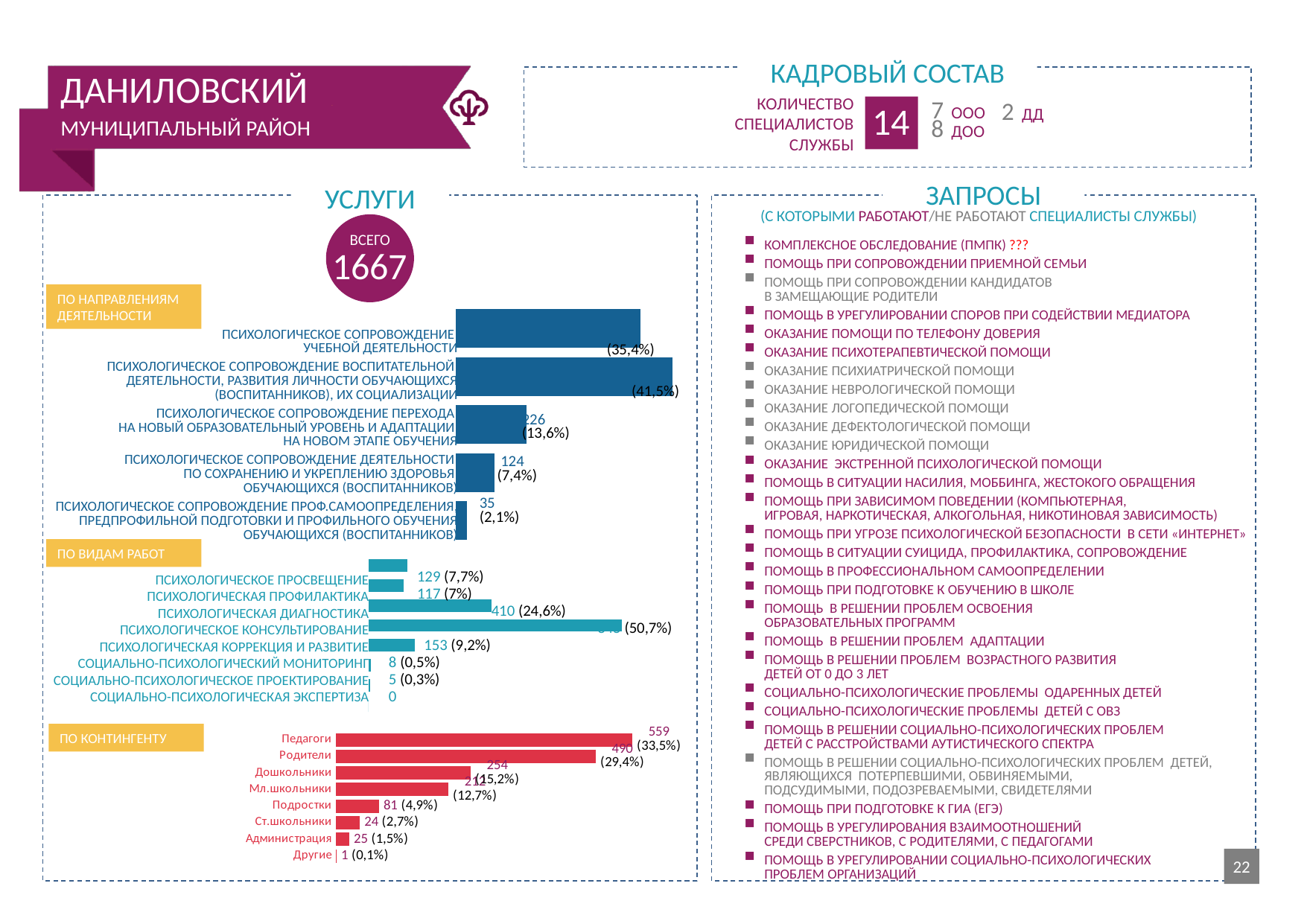
In the 'По видам работ' chart, which category has the highest value? Психологическое консультирование In the 'По контингенту' chart, which category has the highest value? Педагоги In the 'По видам работ' chart, what value is shown for Психологическая диагностика? 410 (24,6%) In the 'По видам работ' chart, what value is shown for Психологическое просвещение? 129 (7,7%) What type of chart is used in the 'По направлениям деятельности' section? Bar chart In the 'По видам работ' chart, what is the difference between Психологическая диагностика and Психологическая коррекция и развитие? 257 In the 'По контингенту' chart, which is larger: Родители or Дошкольники? Родители In the 'По видам работ' chart, which category has the lowest value? Социально-психологическая экспертиза In the 'По направлениям деятельности' chart, what value is shown for Психологическое сопровождение деятельности по сохранению и укреплению здоровья обучающихся? 124 (7,4%) In the 'По контингенту' chart, what value is shown for Подростки? 81 (4,9%) In the 'По контингенту' chart, what value is shown for Педагоги? 559 (33,5%) In the 'По контингенту' chart, how many categories are shown? 8